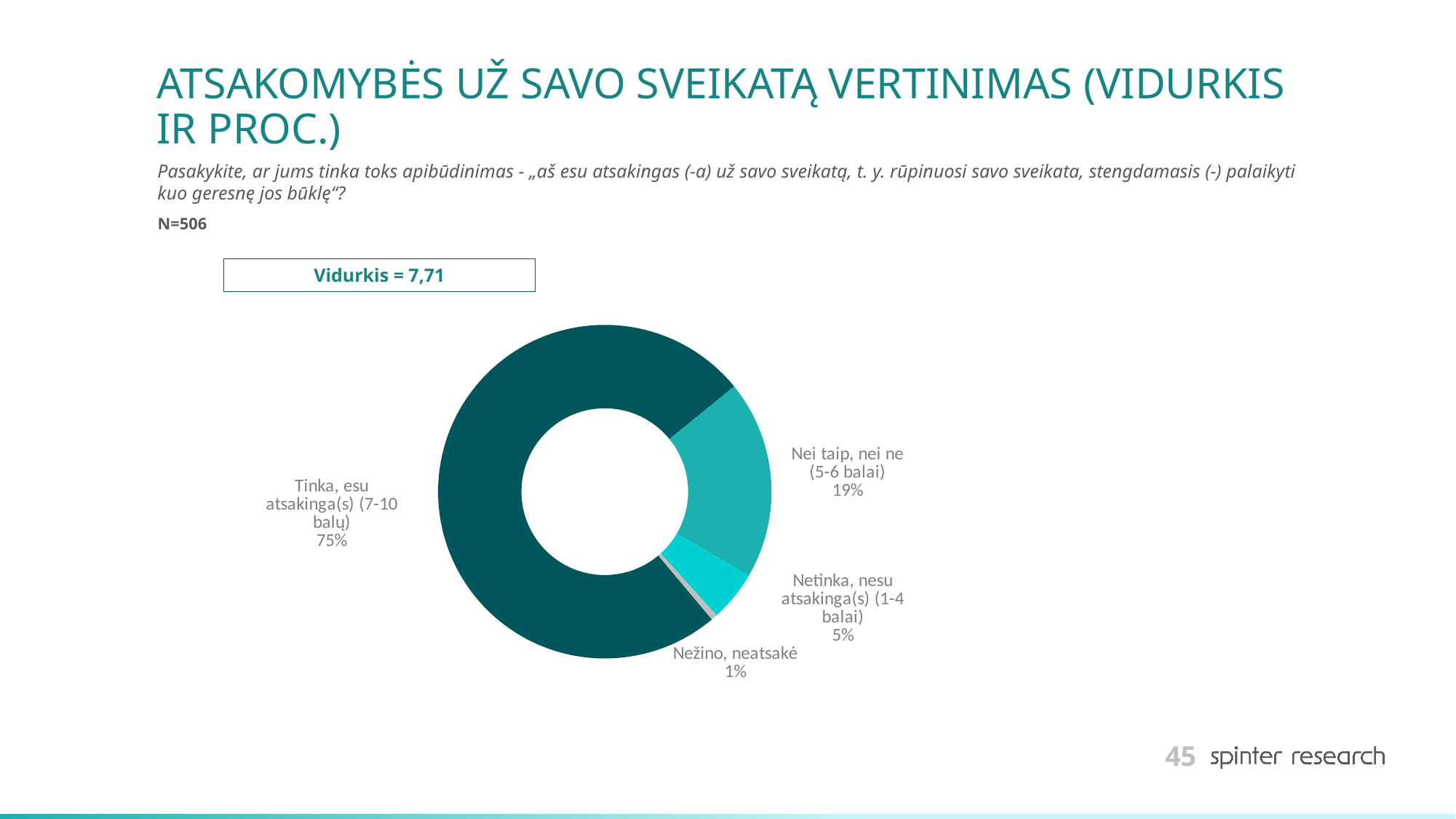
What kind of chart is shown on the slide? Doughnut (pie) chart What is the sample size (N) shown on the slide? 506 What percentage of respondents answered "Nei taip, nei ne (5-6 balai)"? 19% Which category has the largest share of the chart? Tinka, esu atsakinga(s) (7-10 balų) What average value (Vidurkis) is shown on the slide? 7,71 How many categories are shown in the chart? 4 Which category has the smallest share of the chart? Nežino, neatsakė What percentage of respondents answered "Nežino, neatsakė"? 1% What is the difference in percentage points between "Tinka, esu atsakinga(s) (7-10 balų)" and "Nei taip, nei ne (5-6 balai)"? 56 percentage points What percentage of respondents answered "Tinka, esu atsakinga(s) (7-10 balų)"? 75% Which is larger: the share for "Nei taip, nei ne (5-6 balai)" or for "Netinka, nesu atsakinga(s) (1-4 balai)"? Nei taip, nei ne (5-6 balai) What percentage of respondents answered "Netinka, nesu atsakinga(s) (1-4 balai)"? 5%